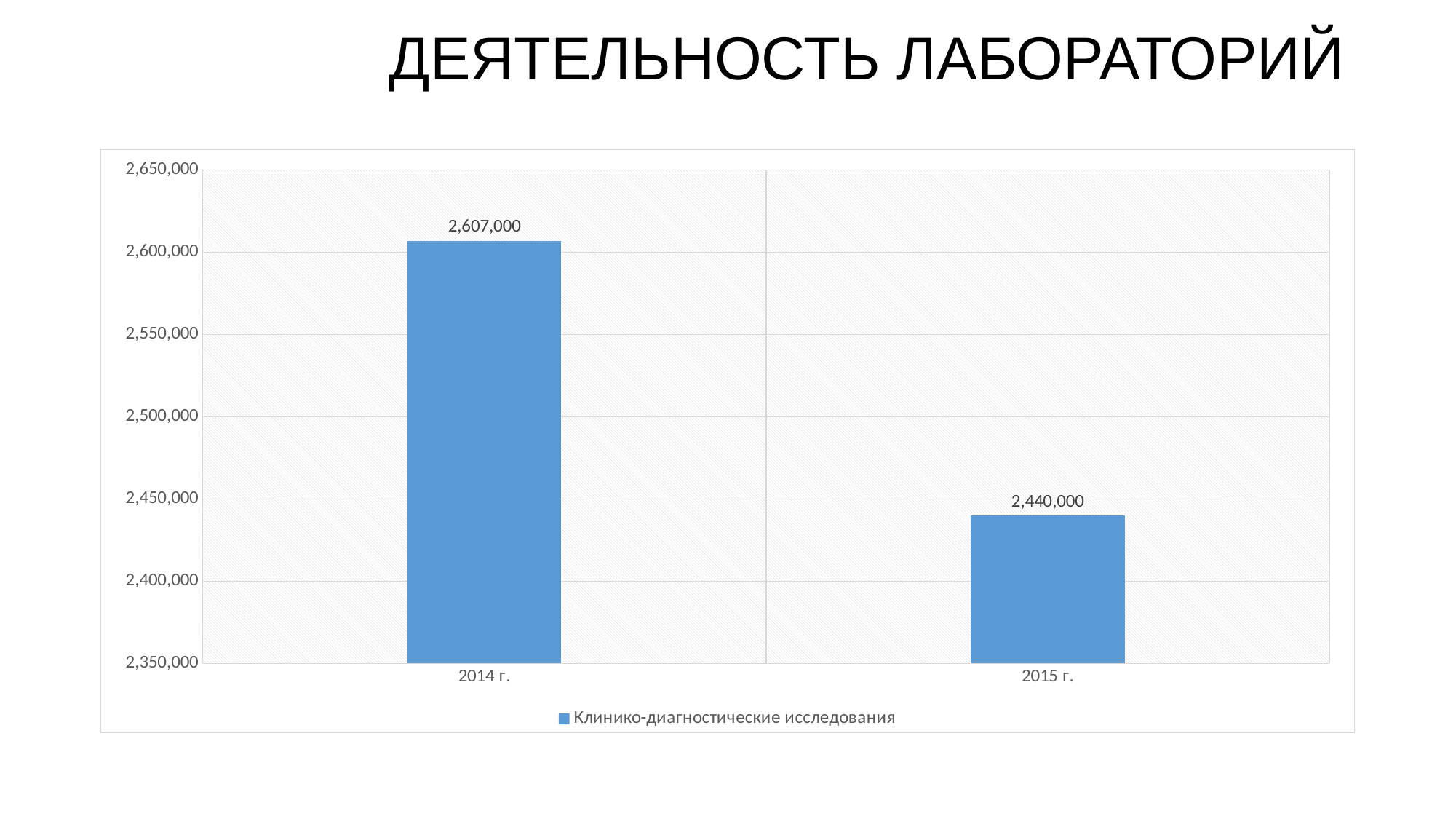
Is the value for 2015 г. greater or less than 2,450,000? less Which year has the highest value? 2014 г. What is the difference between the values for 2014 г. and 2015 г.? 167,000 How many series does the legend list? 1 Is the value for 2014 г. greater or less than 2,600,000? greater What is the value for 2015 г.? 2,440,000 Do the values rise or fall from 2014 г. to 2015 г.? fall How many categories are shown on the x axis? 2 What kind of chart is shown on the slide? bar chart What is the value for 2014 г.? 2,607,000 Which year has the lowest value? 2015 г. Which is larger, the value for 2014 г. or the value for 2015 г.? 2014 г.